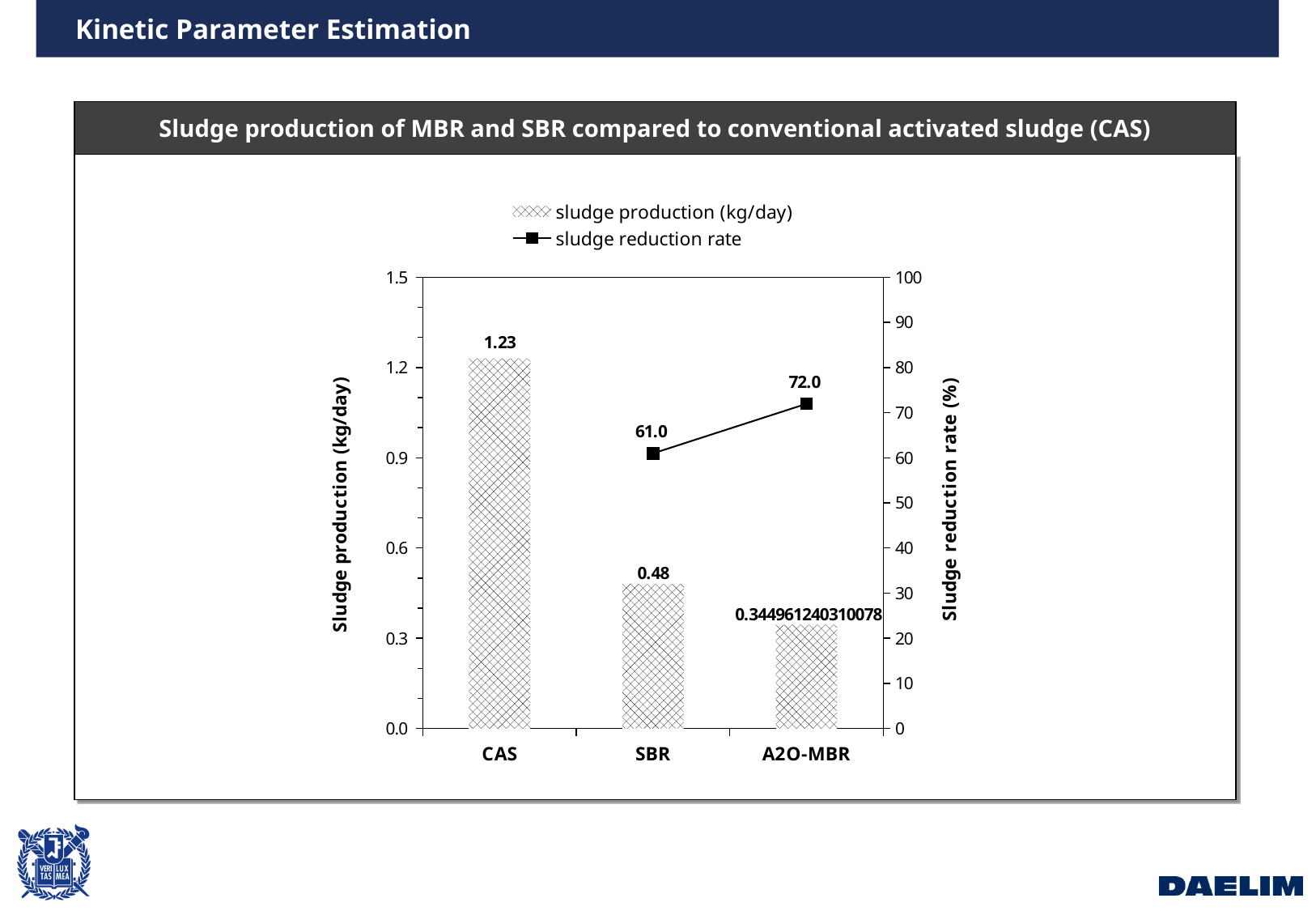
What is the title of the chart? Sludge production of MBR and SBR compared to conventional activated sludge (CAS) What is the sludge reduction rate for A2O-MBR? 72.0 What is the sludge production (kg/day) for SBR? 0.48 What is the sludge production (kg/day) for CAS? 1.23 What is the sludge reduction rate for SBR? 61.0 How many categories are shown on the x axis? 3 How many series does the legend list? 2 What is the difference in sludge reduction rate between A2O-MBR and SBR? 11.0 Which has a higher sludge reduction rate, SBR or A2O-MBR? A2O-MBR What is the difference in sludge production (kg/day) between CAS and SBR? 0.75 Which category has the highest sludge production (kg/day)? CAS Which category has the lowest sludge production (kg/day)? A2O-MBR